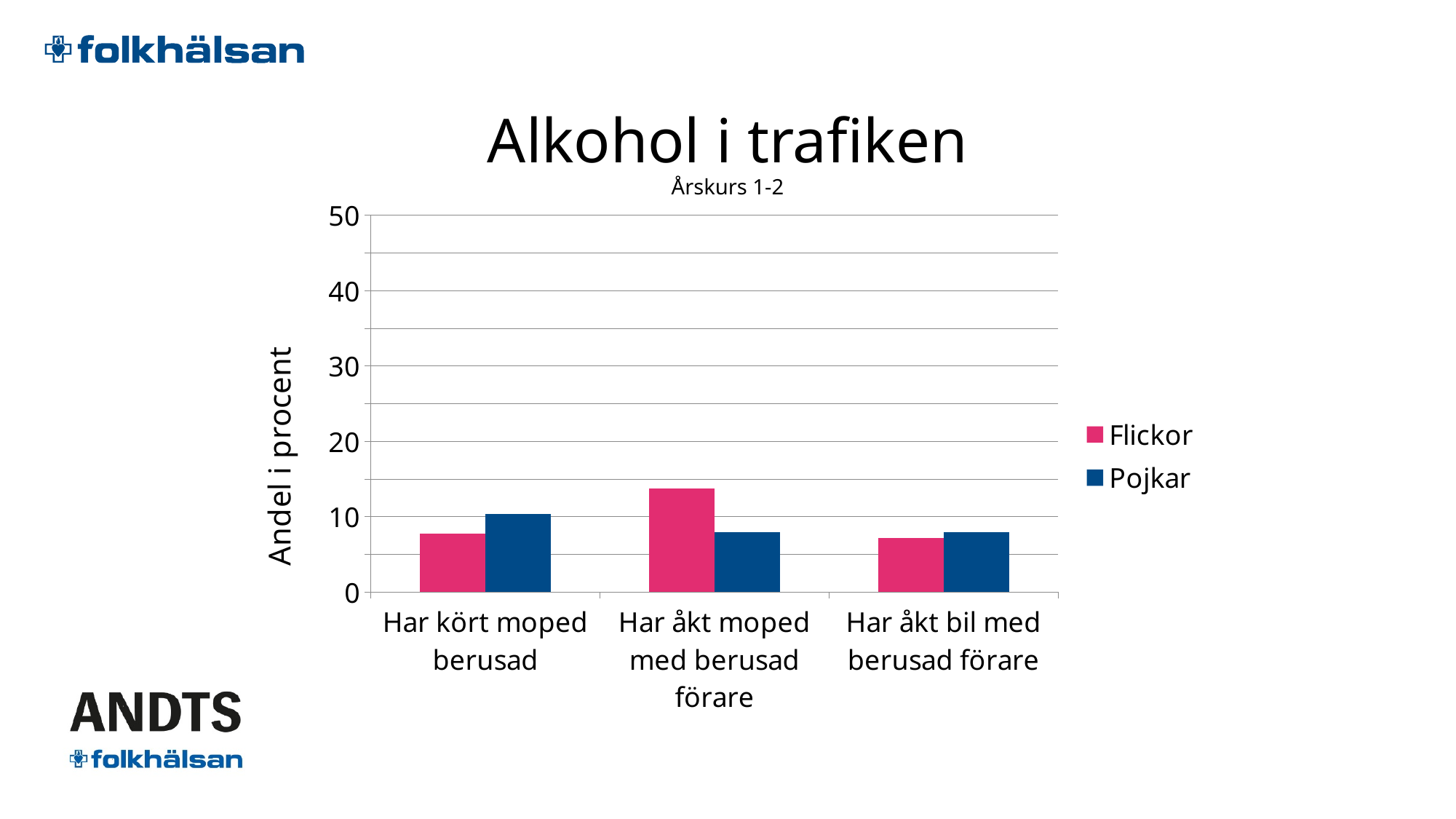
Is the Flickor value for 'Har åkt moped med berusad förare' greater or less than 10? greater For 'Har kört moped berusad', which is larger, Flickor or Pojkar? Pojkar How many categories are shown on the x axis of the chart? 3 For which category is the Pojkar value highest? Har kört moped berusad Is the Pojkar value for 'Har åkt bil med berusad förare' greater or less than 10? less How many series does the chart's legend list? 2 Which series are listed in the chart's legend? Flickor and Pojkar For 'Har åkt moped med berusad förare', which is larger, Flickor or Pojkar? Flickor For which category is the Flickor value highest? Har åkt moped med berusad förare What kind of chart is shown on the slide? bar chart Is the Flickor value for 'Har kört moped berusad' greater or less than 10? less What is the title of the chart's vertical axis? Andel i procent